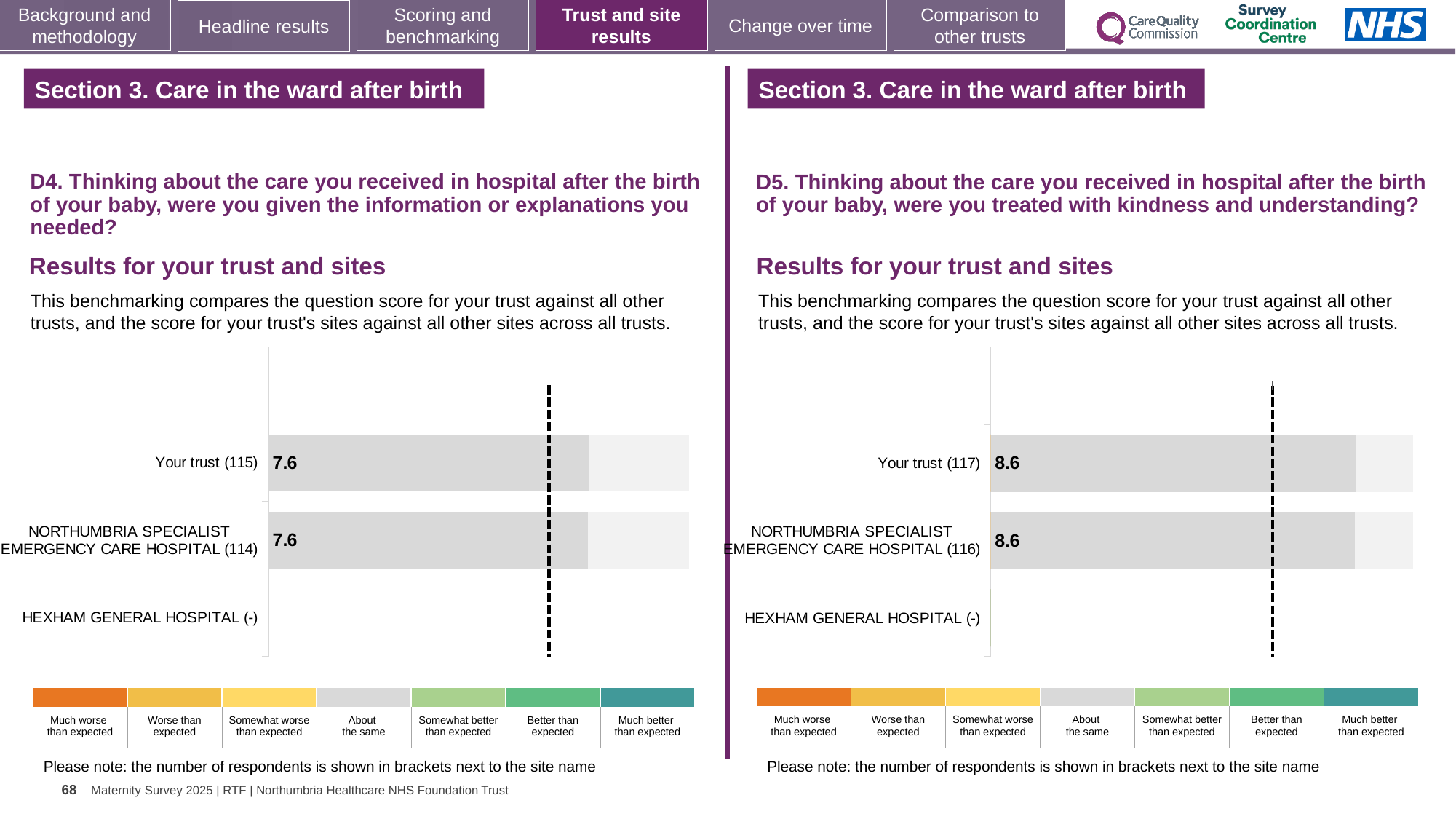
What kind of chart is the D4 chart on the left? bar chart In the D4 chart on the left, what is the score for Northumbria Specialist Emergency Care Hospital? 7.6 In the D4 chart on the left, what is the score for Your trust? 7.6 In the D5 chart on the right, how many respondents are shown in brackets next to Your trust? 117 In the D4 chart on the left, which category has no bar plotted? Hexham General Hospital (-) How many site/trust categories are listed on the y axis of the D4 chart on the left? 3 In the D5 chart on the right, what is the score for Your trust? 8.6 In the D4 chart on the left, what is the difference between the score for Your trust and the score for Northumbria Specialist Emergency Care Hospital? 0.0 How many site/trust categories are listed on the y axis of the D5 chart on the right? 3 In the D5 chart on the right, is the score for Your trust larger than, smaller than, or equal to the score for Northumbria Specialist Emergency Care Hospital? equal In the D5 chart on the right, what is the score for Northumbria Specialist Emergency Care Hospital? 8.6